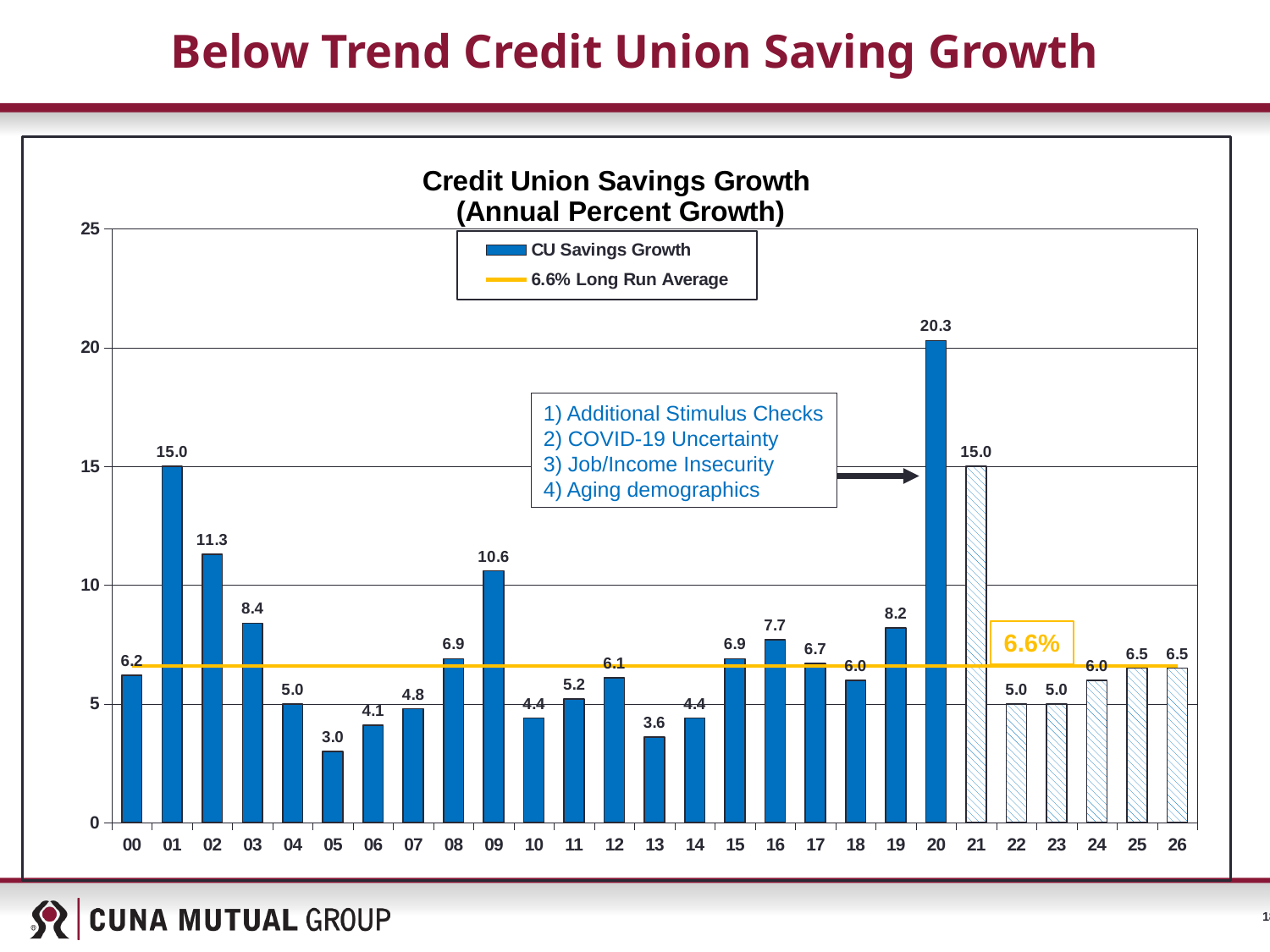
Which year has the lowest CU Savings Growth? 05 Which is larger, the CU Savings Growth value for 2001 or for 2002? 2001 (15.0) What is the CU Savings Growth value for 2005 (label '05')? 3.0 What is the title of the chart? Credit Union Savings Growth (Annual Percent Growth) What is the difference between the CU Savings Growth values for 2020 and 2021? 5.3 What kind of chart is shown on the slide? Bar chart How many years are shown on the x axis of the chart? 27 Which year has the highest CU Savings Growth? 20 What is the CU Savings Growth value for 2020 (label '20')? 20.3 What is the long run average value shown by the horizontal line? 6.6% How many entries does the chart legend list? 2 Do the CU Savings Growth values rise or fall from 2022 to 2026? Rise